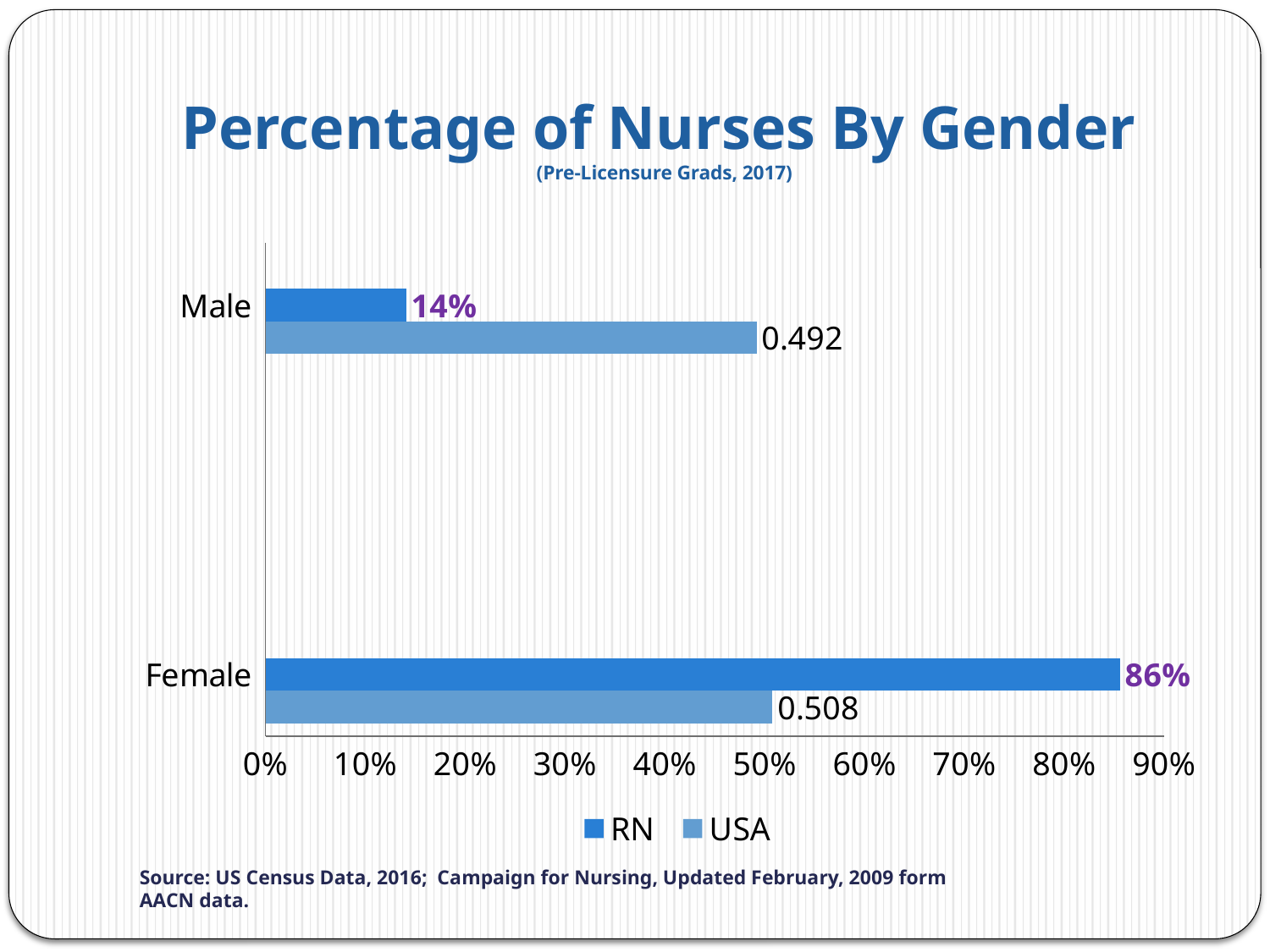
Which category has the lowest RN value? Male What kind of chart is shown on the slide? Bar chart How many series does the legend list? 2 For Female, which series has the larger value, RN or USA? RN How many categories are shown on the chart? 2 For Male, which series has the larger value, RN or USA? USA What is the difference between the RN values for Female and Male? 72% What is the USA value for Male? 0.492 What is the RN value for Male? 14% Which category has the highest RN value? Female What is the USA value for Female? 0.508 What is the RN value for Female? 86%